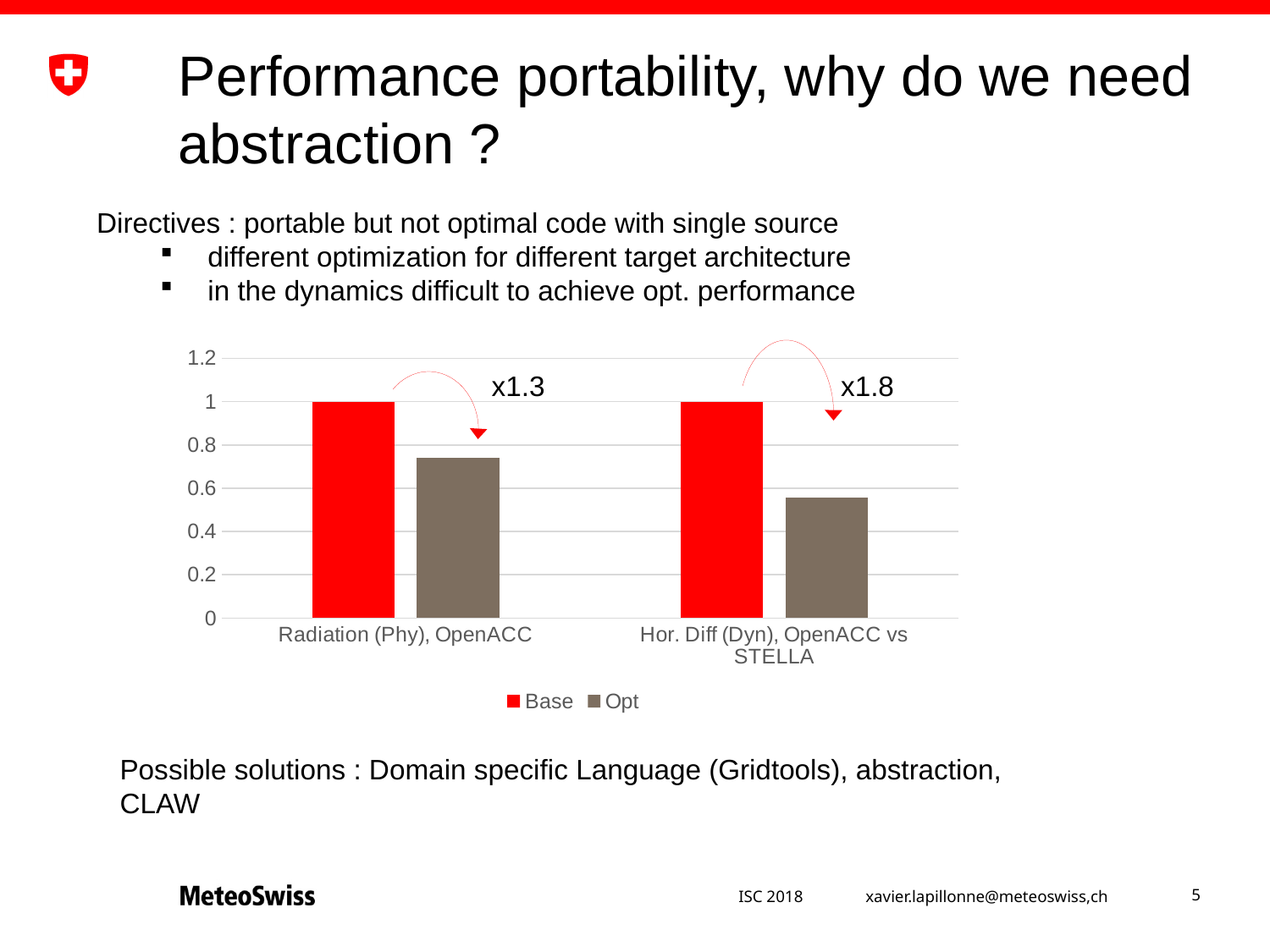
What is the Base value for Hor. Diff (Dyn), OpenACC vs STELLA? 1 Is the Opt value for Radiation (Phy), OpenACC greater or less than 0.8? less What kind of chart is shown on the slide? bar chart What is the Base value for Radiation (Phy), OpenACC? 1 Is the Opt value for Radiation (Phy), OpenACC greater or less than 0.6? greater Which category has the larger Opt value: Radiation (Phy), OpenACC or Hor. Diff (Dyn), OpenACC vs STELLA? Radiation (Phy), OpenACC How many series does the chart legend list? 2 How many categories are shown on the x axis of the chart? 2 Which bar in the chart is the lowest? Opt for Hor. Diff (Dyn), OpenACC vs STELLA Is the Opt value for Hor. Diff (Dyn), OpenACC vs STELLA greater or less than 0.6? less Which is larger for Radiation (Phy), OpenACC: the Base value or the Opt value? Base What speedup factor is annotated above the Hor. Diff (Dyn), OpenACC vs STELLA bars? x1.8